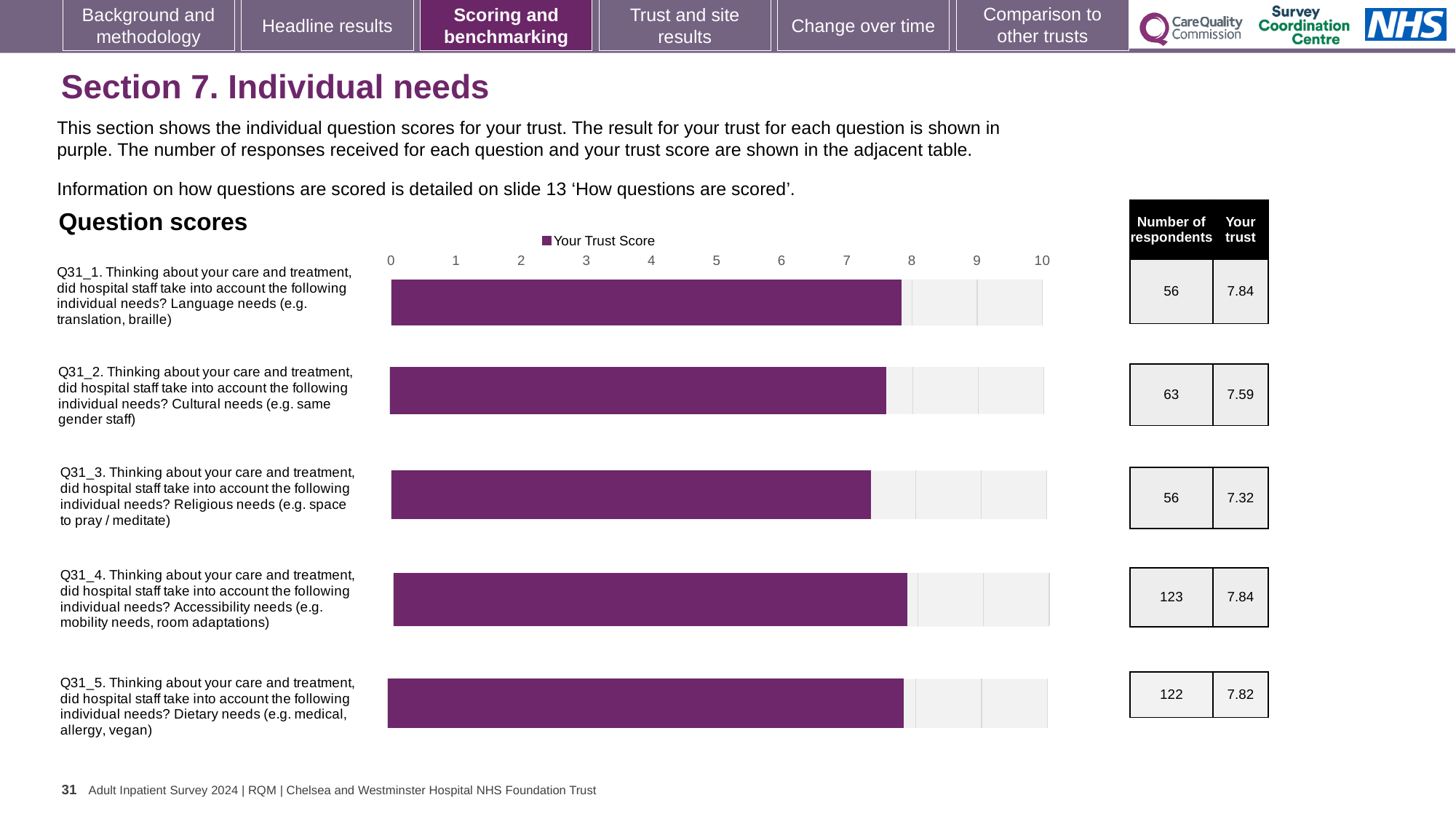
Which has the higher trust score, Q31_2 (Cultural needs) or Q31_3 (Religious needs)? Q31_2 (Cultural needs) Is the trust score for Q31_3 (Religious needs) greater or less than 7? greater What is the trust score for Q31_1 (Language needs)? 7.84 What kind of chart is used to show the question scores? Bar chart Is the trust score for Q31_2 (Cultural needs) greater or less than 8? less What is the difference between the trust scores for Q31_1 (Language needs) and Q31_3 (Religious needs)? 0.52 Which question has the lowest trust score on the slide? Q31_3 (Religious needs) What is the trust score for Q31_3 (Religious needs)? 7.32 What is the difference between the trust scores for Q31_2 (Cultural needs) and Q31_3 (Religious needs)? 0.27 What series does the chart legend list? Your Trust Score How many respondents answered Q31_4 (Accessibility needs)? 123 How many question score bars are shown on the slide? 5